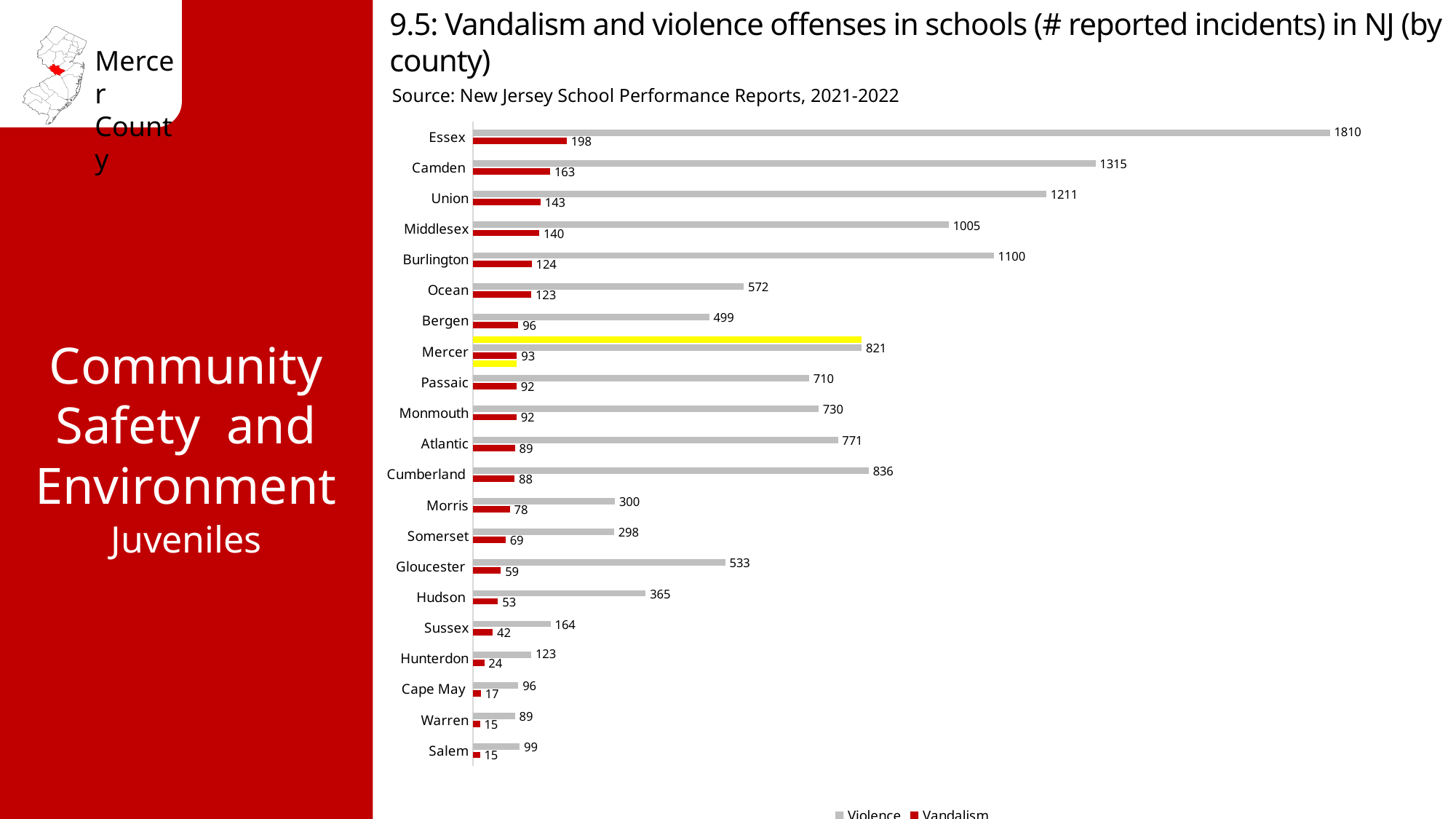
Which county has the lowest number of reported violence incidents? Warren How many counties are shown in the chart? 21 What type of chart is shown on the slide? Bar chart How many series does the legend list? 2 What is the difference between violence and vandalism incidents in Mercer County? 728 What is the number of reported vandalism incidents for Mercer County? 93 What is the number of reported vandalism incidents for Hunterdon County? 24 What is the difference between the violence incidents in Essex and Camden? 495 What is the number of reported violence incidents for Mercer County? 821 Which county has the highest number of reported violence incidents? Essex Which county has more reported violence incidents, Monmouth or Passaic? Monmouth Which county's bars are highlighted in yellow on the chart? Mercer